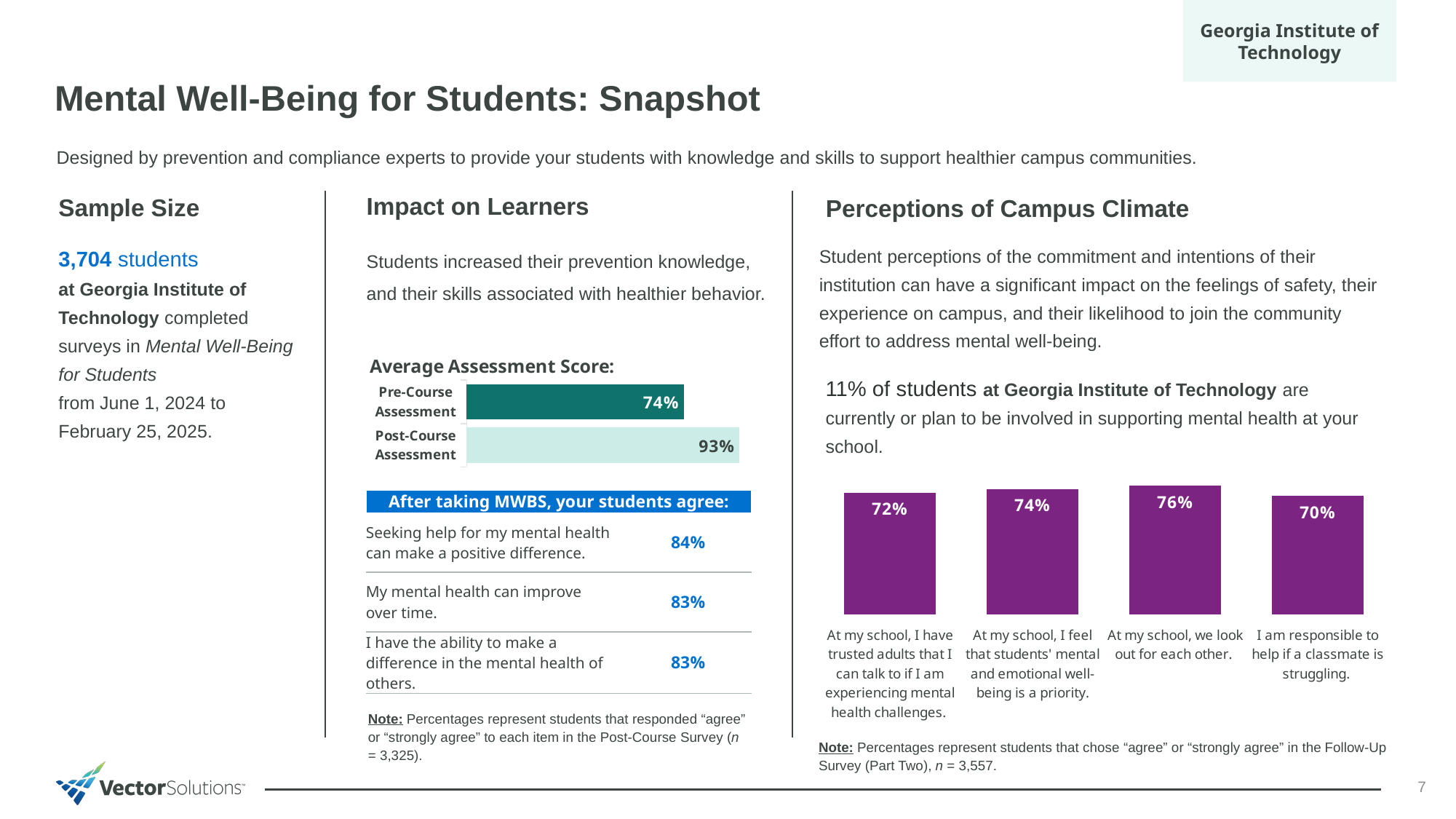
In the Perceptions of Campus Climate bar chart, what percentage of students agree that 'At my school, we look out for each other'? 76% In the Perceptions of Campus Climate bar chart, which statement has the lowest percentage of agreement? I am responsible to help if a classmate is struggling. In the Average Assessment Score chart, which assessment has the higher score? Post-Course Assessment In the Perceptions of Campus Climate bar chart, what percentage of students agree that 'At my school, I have trusted adults that I can talk to if I am experiencing mental health challenges'? 72% In the Perceptions of Campus Climate bar chart, which statement has the highest percentage of agreement? At my school, we look out for each other. What kind of chart is the Average Assessment Score chart? Bar chart In the Perceptions of Campus Climate bar chart, what is the difference between the percentage for 'At my school, I feel that students' mental and emotional well-being is a priority' and 'I am responsible to help if a classmate is struggling'? 4% In the Average Assessment Score chart, what is the difference between the Post-Course and Pre-Course Assessment scores? 19% In the Perceptions of Campus Climate bar chart, what percentage of students agree that 'I am responsible to help if a classmate is struggling'? 70% In the Average Assessment Score chart, what is the Post-Course Assessment score? 93% In the Average Assessment Score chart, what is the Pre-Course Assessment score? 74% How many bars are shown in the Perceptions of Campus Climate bar chart? 4